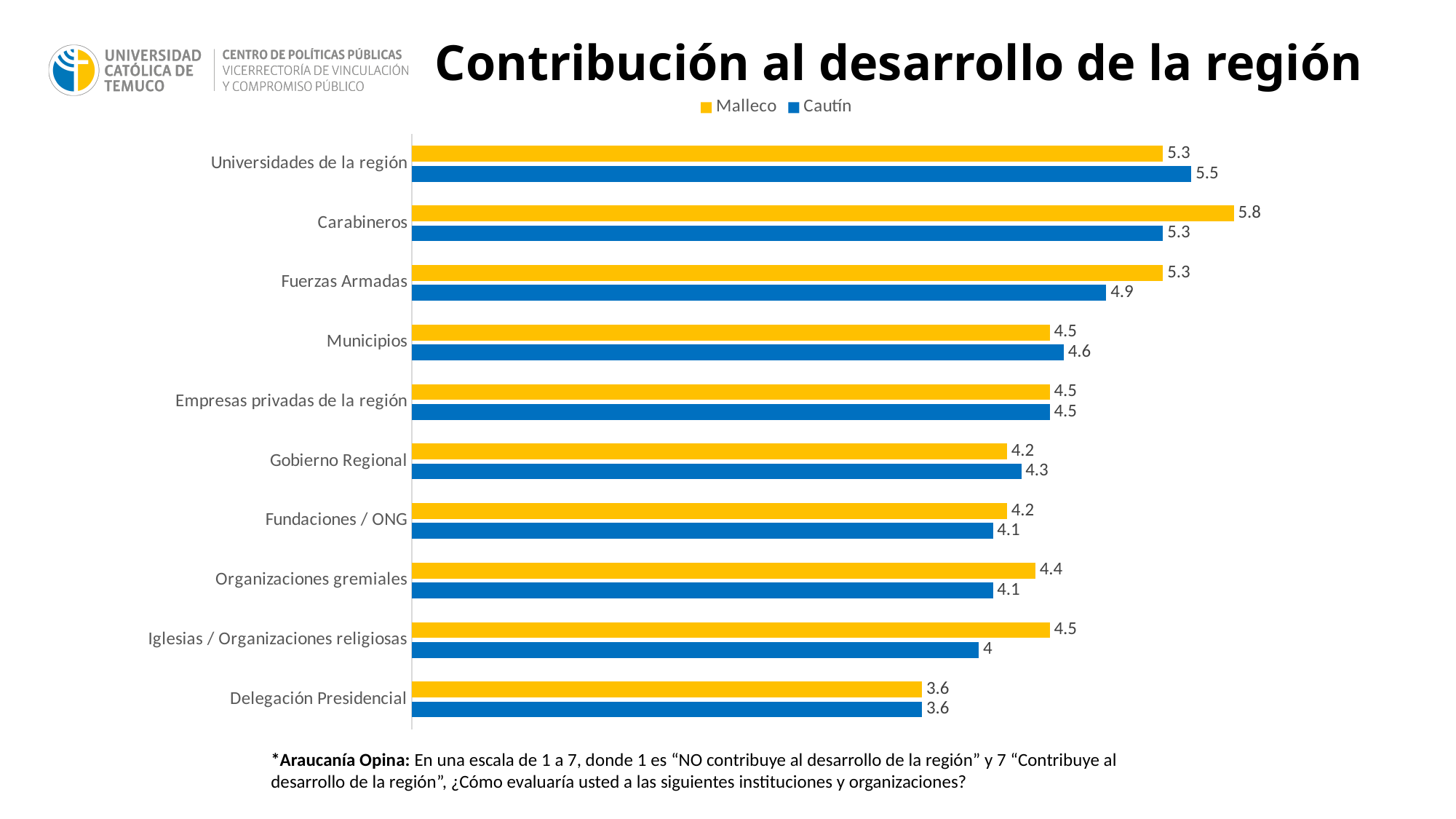
What is the Cautín value for Universidades de la región? 5.5 What is the difference between the Malleco and Cautín values for Iglesias / Organizaciones religiosas? 0.5 What is the Malleco value for Delegación Presidencial? 3.6 What is the Malleco value for Carabineros? 5.8 How many series does the legend list? 2 What is the difference between the Malleco and Cautín values for Carabineros? 0.5 What is the Cautín value for Iglesias / Organizaciones religiosas? 4 How many categories are shown on the chart? 10 For Fuerzas Armadas, which is larger: the Malleco value or the Cautín value? Malleco What kind of chart is shown on the slide? Bar chart Which category has the highest Malleco value? Carabineros Which category has the lowest Cautín value? Delegación Presidencial